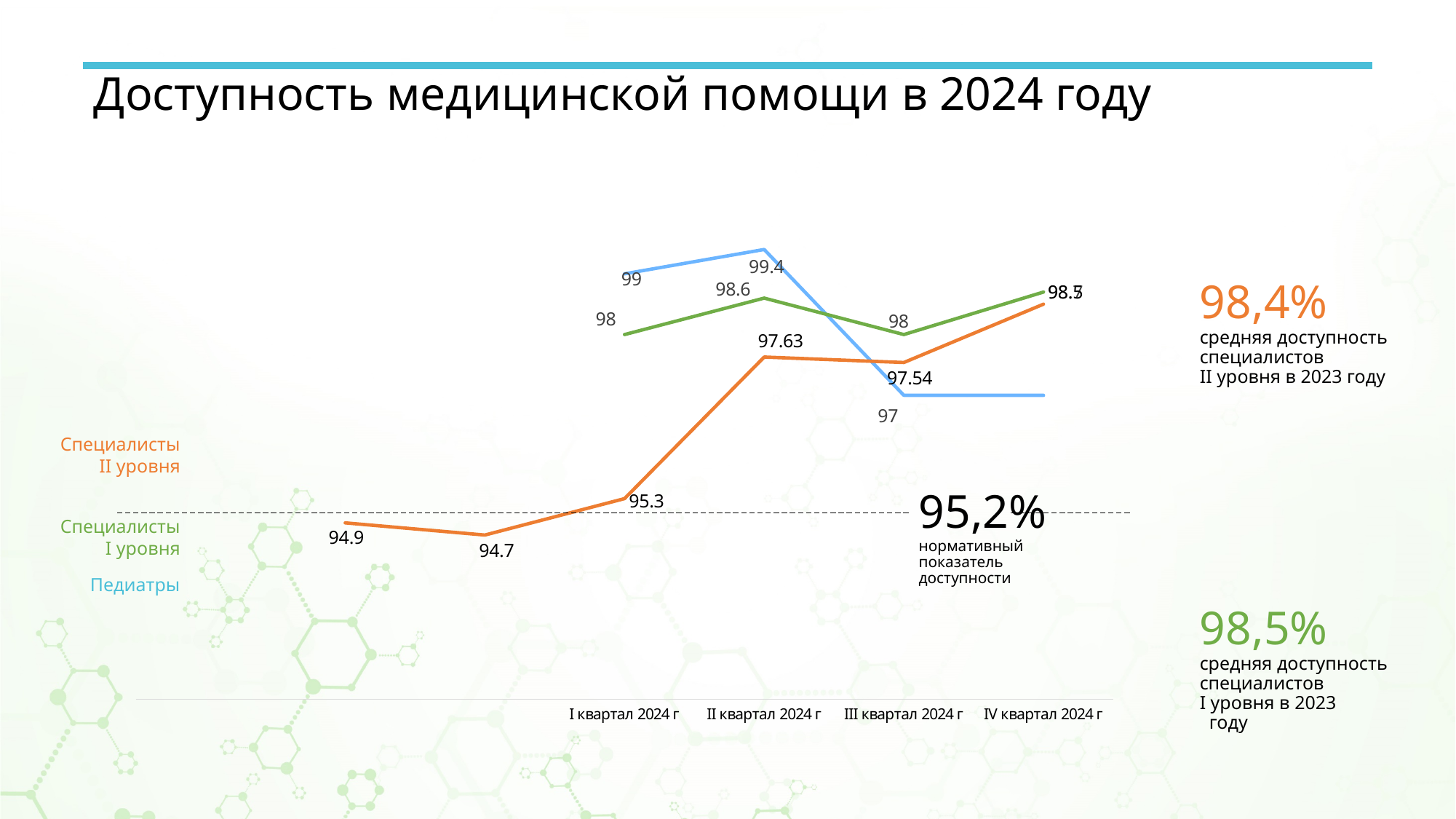
In II квартал 2024 г, which is higher: Педиатры or Специалисты I уровня? Педиатры What kind of chart is shown on the slide? line chart How many quarters are labelled on the x axis of the chart? 4 What is the value for Специалисты II уровня in II квартал 2024 г? 97.63 What is the value for Специалисты I уровня in II квартал 2024 г? 98.6 What is the value for Педиатры in III квартал 2024 г? 97 In which quarter does the Педиатры series reach its highest value? II квартал 2024 г What is the value for Педиатры in II квартал 2024 г? 99.4 What is the difference between the Педиатры values in II квартал 2024 г and III квартал 2024 г? 2.4 What normative accessibility indicator (нормативный показатель доступности) is marked by the dashed line on the chart? 95,2% What is the value for Специалисты II уровня in III квартал 2024 г? 97.54 How many series are plotted on the chart? 3